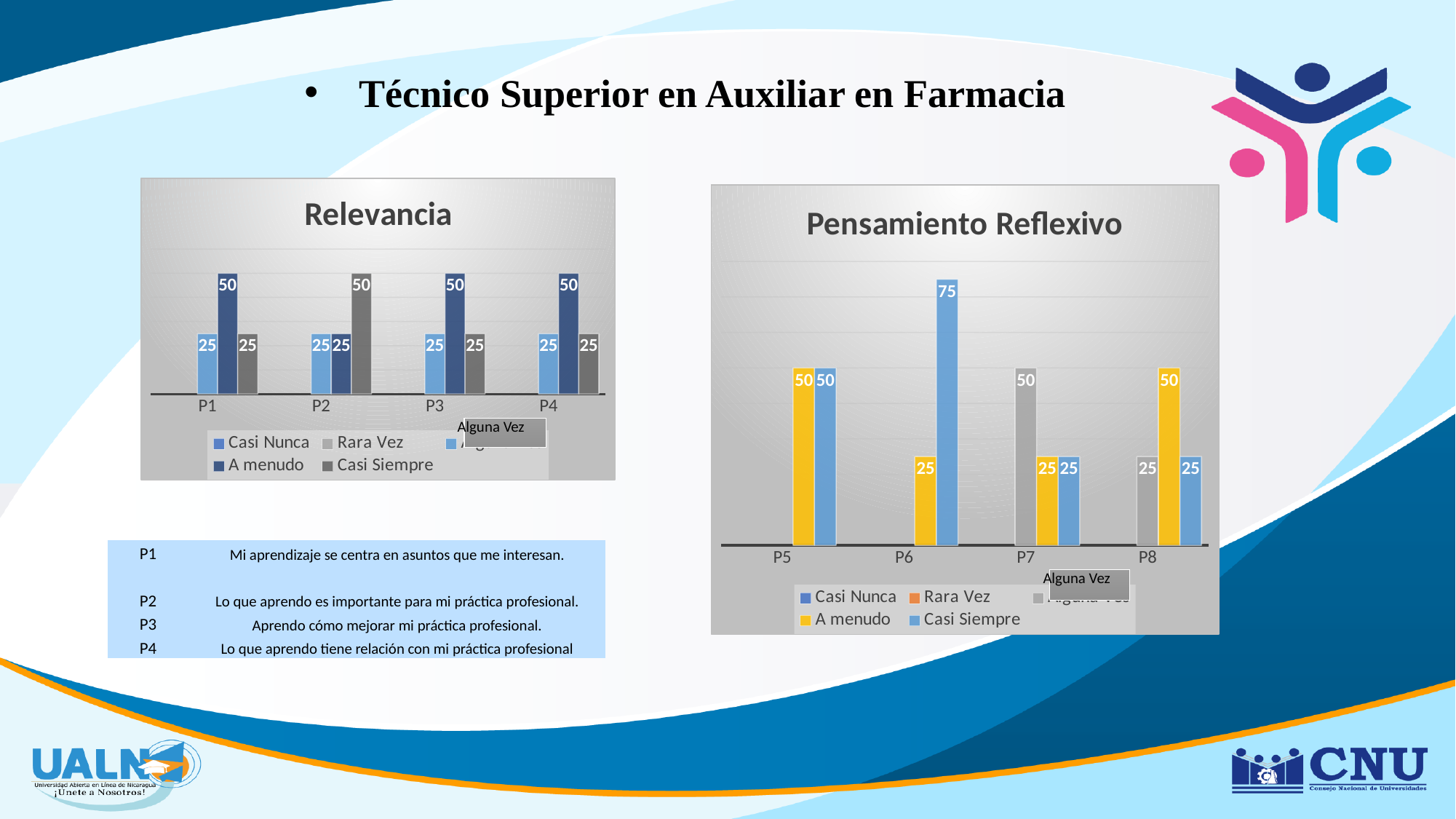
In the "Pensamiento Reflexivo" chart, which category has the highest single bar? P6 What is the title of the chart on the right side of the slide? Pensamiento Reflexivo What kind of chart is the "Relevancia" chart? bar chart In the "Pensamiento Reflexivo" chart, what is the value of "A menudo" for P8? 50 In the "Pensamiento Reflexivo" chart, what is the difference between "Casi Siempre" and "A menudo" for P6? 50 In the "Pensamiento Reflexivo" chart, for P7, which is larger: "Alguna Vez" or "A menudo"? Alguna Vez In the "Pensamiento Reflexivo" chart, what is the value of "Casi Siempre" for P6? 75 In the "Relevancia" chart, what is the value of "Casi Siempre" for P2? 50 In the "Relevancia" chart, what is the value of "Alguna Vez" for P3? 25 How many categories are shown on the x axis of the "Relevancia" chart? 4 How many series does the legend of the "Pensamiento Reflexivo" chart list? 5 In the "Relevancia" chart, what is the value of "A menudo" for P2? 25